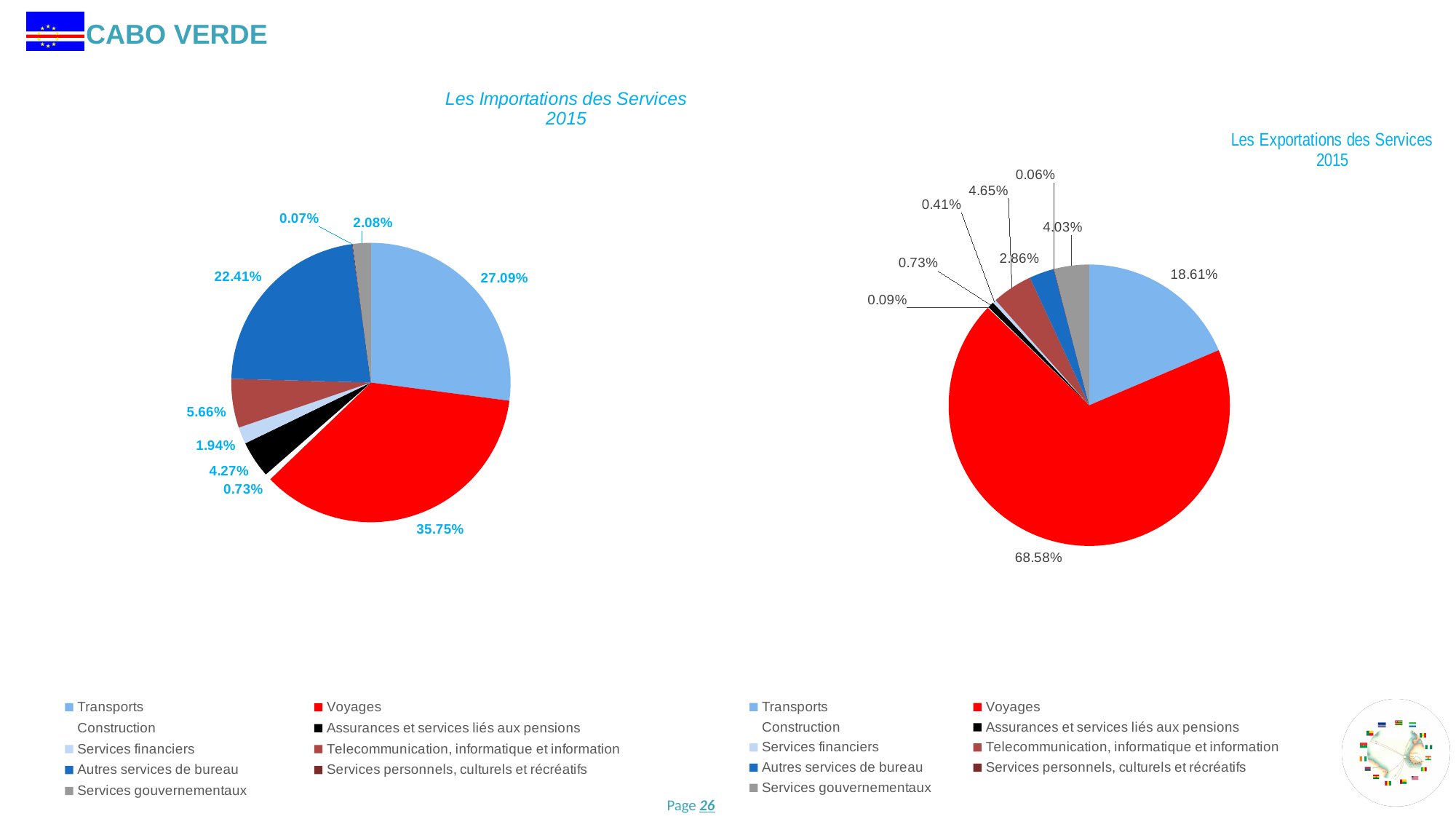
What is the difference between the Voyages share in 'Les Exportations des Services 2015' and the Voyages share in 'Les Importations des Services 2015'? 32.83 percentage points In 'Les Exportations des Services 2015', what share does Voyages have? 68.58% In 'Les Importations des Services 2015', what is the difference between the Voyages share and the Transports share? 8.66 percentage points In 'Les Importations des Services 2015', which category has the largest slice? Voyages How many categories does the legend of 'Les Exportations des Services 2015' list? 9 In 'Les Importations des Services 2015', what share does Autres services de bureau have? 22.41% In 'Les Importations des Services 2015', what share does Voyages have? 35.75% What kind of chart is 'Les Importations des Services 2015'? pie chart In 'Les Exportations des Services 2015', what share does Transports have? 18.61% In 'Les Exportations des Services 2015', which category has the largest slice? Voyages In 'Les Importations des Services 2015', what share does Transports have? 27.09% In 'Les Importations des Services 2015', which is larger, Transports or Autres services de bureau? Transports